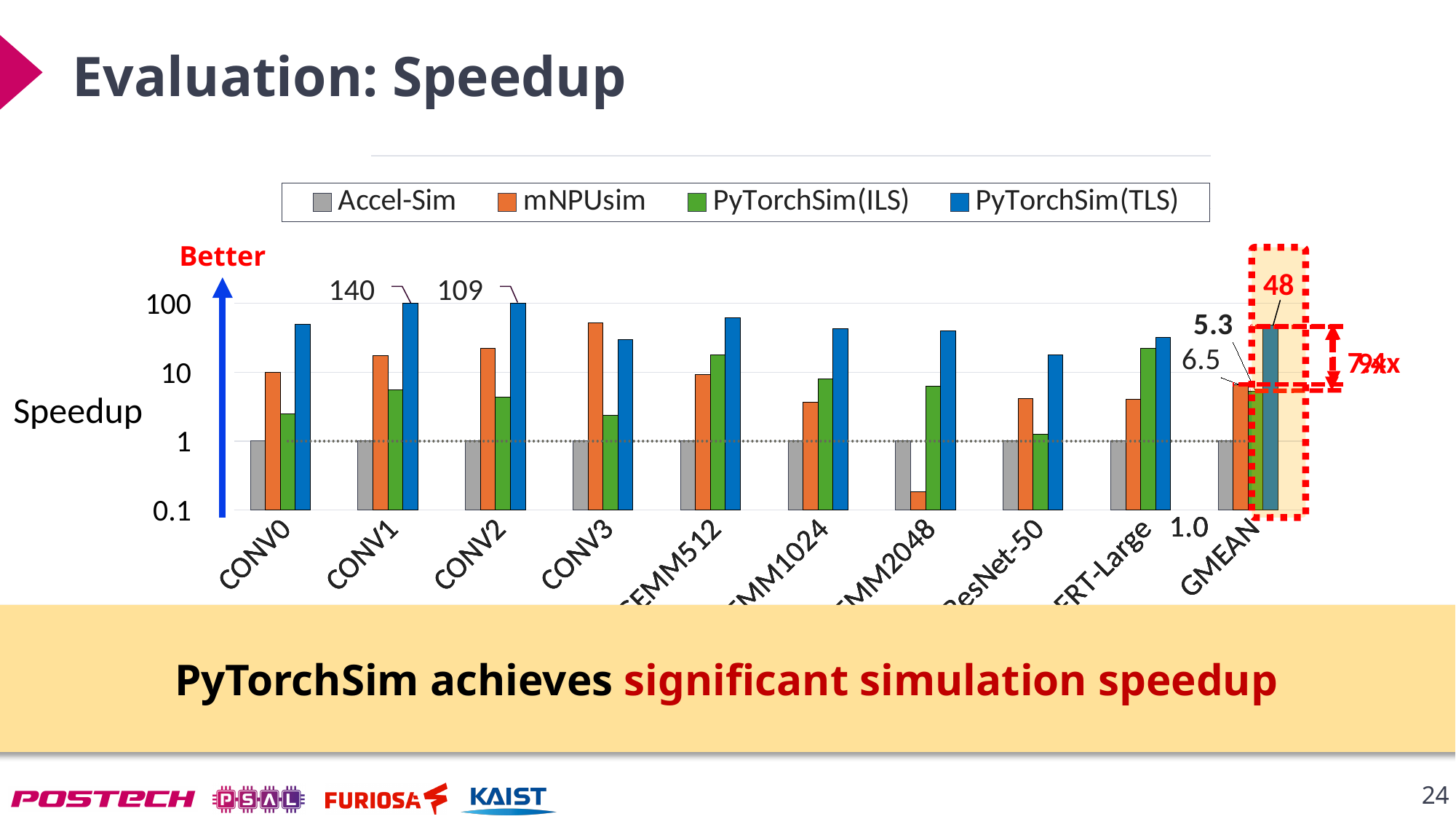
What label is shown on the y axis? Speedup What type of chart is shown on the slide? bar chart What is the GMEAN speedup labelled for Accel-Sim? 1.0 How many series does the legend list? 4 What is the difference between the labelled PyTorchSim(TLS) speedups for CONV1 and CONV2? 31 What is the speedup value labelled for PyTorchSim(TLS) on CONV1? 140 Is the PyTorchSim(TLS) speedup for CONV0 greater or less than 10? greater Is the mNPUsim speedup for GEMM2048 greater or less than 1? less For which category is the PyTorchSim(TLS) bar highest? CONV1 What is the speedup value labelled for PyTorchSim(TLS) on CONV2? 109 What is the GMEAN speedup labelled for PyTorchSim(TLS)? 48 How many categories are shown along the x axis? 10